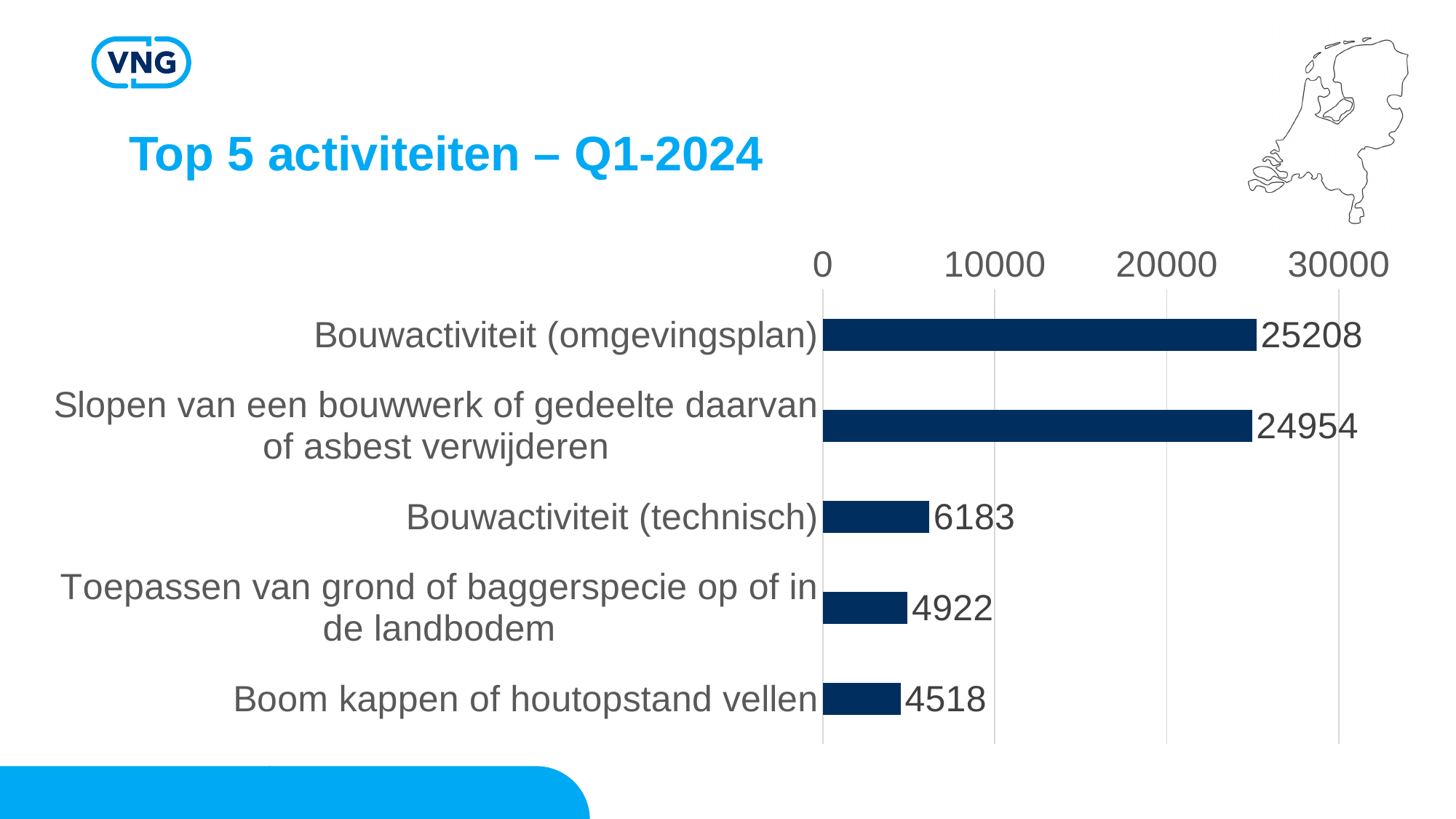
Which activity has the highest value? Bouwactiviteit (omgevingsplan) Which activity has the lowest value? Boom kappen of houtopstand vellen What is the value for Bouwactiviteit (technisch)? 6183 How many activities are shown in the chart? 5 What is the value for Toepassen van grond of baggerspecie op of in de landbodem? 4922 What is the value for Boom kappen of houtopstand vellen? 4518 What is the value for Bouwactiviteit (omgevingsplan)? 25208 What is the difference between Bouwactiviteit (omgevingsplan) and Slopen van een bouwwerk of gedeelte daarvan of asbest verwijderen? 254 Which is larger: Bouwactiviteit (technisch) or Toepassen van grond of baggerspecie op of in de landbodem? Bouwactiviteit (technisch) What is the difference between Bouwactiviteit (technisch) and Boom kappen of houtopstand vellen? 1665 What is the value for Slopen van een bouwwerk of gedeelte daarvan of asbest verwijderen? 24954 What kind of chart is shown on the slide? Bar chart